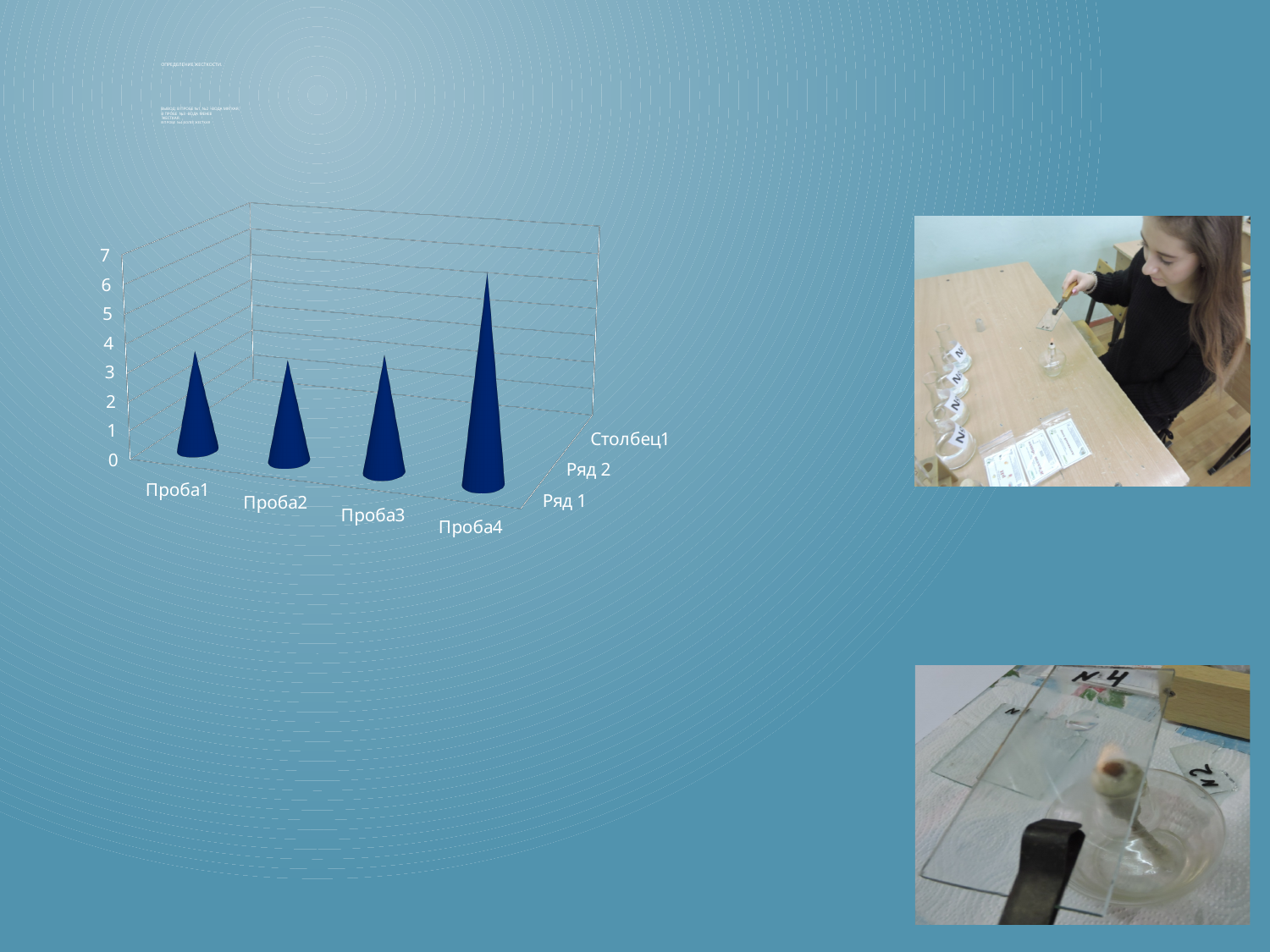
Which is larger, the value for Проба3 or the value for Проба4? Проба4 What is the highest value shown on the vertical axis of the chart? 7 How many series labels are shown on the depth axis of the chart? 3 What kind of chart is shown on the slide? bar chart Is the value for Проба2 greater or less than 5? less How many categories are plotted along the x axis of the chart? 4 What is the label of the first category on the x axis? Проба1 Is the value for Проба3 greater or less than 5? less Is the value for Проба4 greater or less than 4? greater Which is larger, the value for Проба1 or the value for Проба4? Проба4 Which category has the highest value in the chart? Проба4